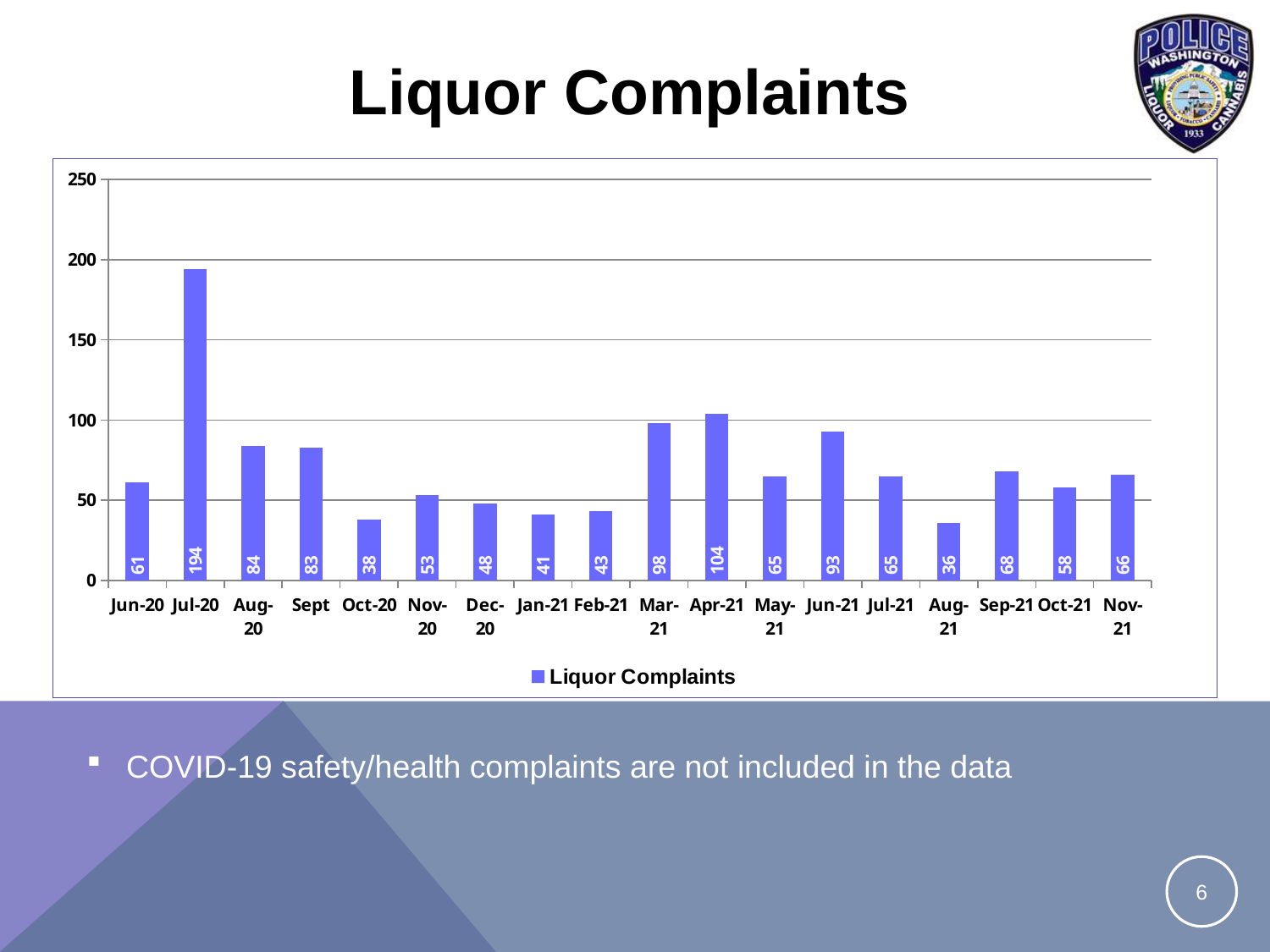
Is the value for Oct-20 greater or less than 50? less What is the difference between the values for Jul-20 and Apr-21? 90 What is the value for Nov-21? 66 How many series does the legend list? 1 Which is larger, the value for Mar-21 or the value for Jun-21? Mar-21 What is the value for Jul-20? 194 What is the value for Apr-21? 104 Which month has the highest number of liquor complaints? Jul-20 Which month has the lowest number of liquor complaints? Aug-21 What is the legend entry for the series? Liquor Complaints What kind of chart is shown? bar chart How many months are shown on the x axis? 18